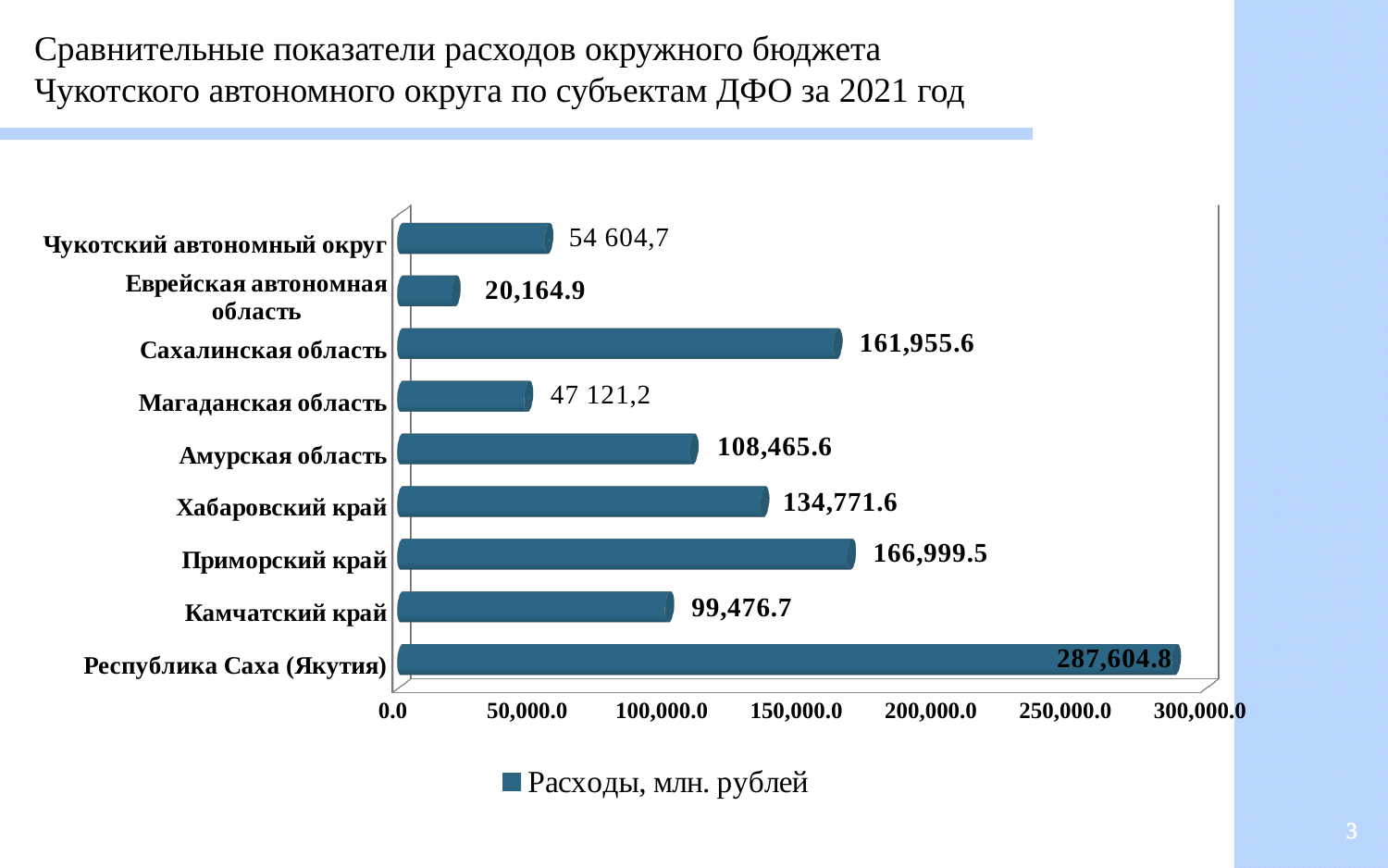
Which region has the highest value? Республика Саха (Якутия) What is the difference between the values for Хабаровский край and Амурская область? 26,306.0 Is the value for Республика Саха (Якутия) greater or less than 250,000.0? greater What kind of chart is shown on the slide? bar chart Which region has the lowest value? Еврейская автономная область What is the value for Магаданская область? 47 121,2 What is the value for Республика Саха (Якутия)? 287,604.8 What is the value for Чукотский автономный округ? 54 604,7 How many regions are shown in the chart? 9 How many series does the legend list? 1 Which is larger, the value for Приморский край or the value for Сахалинская область? Приморский край What is the value for Хабаровский край? 134,771.6